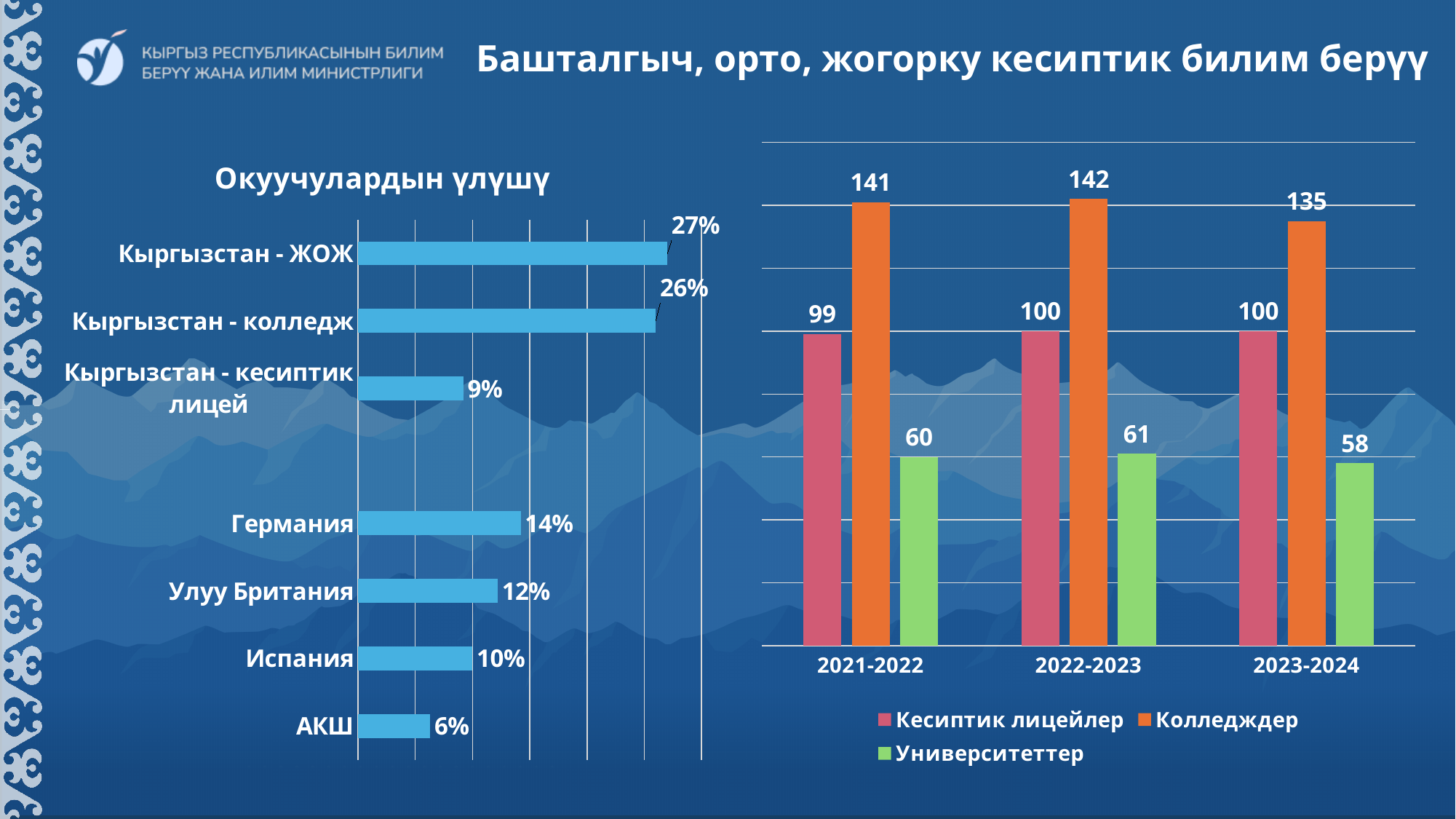
In the chart on the right side of the slide, what is the value for Университеттер in 2023-2024? 58 In the chart titled "Окуучулардын үлүшү", how many categories are shown? 7 In the chart titled "Окуучулардын үлүшү", what kind of chart is it? Bar chart In the chart on the right side of the slide, what is the difference between the Колледждер values for 2022-2023 and 2023-2024? 7 In the chart titled "Окуучулардын үлүшү", what is the difference between the values for Улуу Британия and Испания? 2% In the chart titled "Окуучулардын үлүшү", what is the value for Германия? 14% In the chart titled "Окуучулардын үлүшү", which category has the lowest value? АКШ In the chart on the right side of the slide, which series is shown in orange? Колледждер In the chart on the right side of the slide, which is larger: Кесиптик лицейлер in 2021-2022 or Университеттер in 2021-2022? Кесиптик лицейлер in 2021-2022 In the chart on the right side of the slide, how many series does the legend list? 3 In the chart titled "Окуучулардын үлүшү", which category has the highest value? Кыргызстан - ЖОЖ In the chart on the right side of the slide, what is the value for Колледждер in 2022-2023? 142